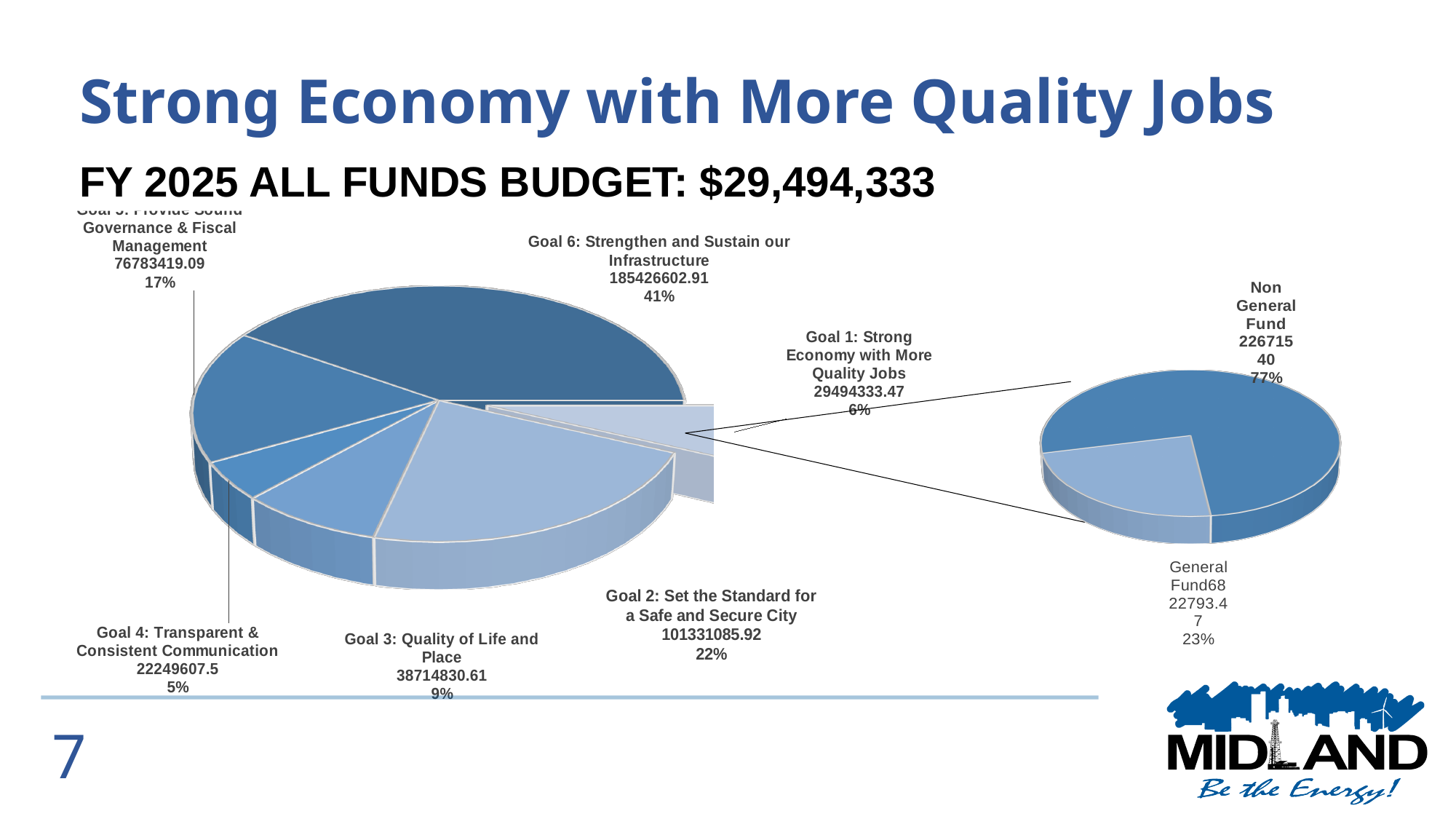
In the main pie chart, what share of the total does Goal 1: Strong Economy with More Quality Jobs represent? 6% In the main pie chart, what percentage is shown for Goal 2: Set the Standard for a Safe and Secure City? 22% In the smaller pie chart on the right, what percentage is shown for Non General Fund? 77% In the main pie chart, what is the value shown for Goal 6: Strengthen and Sustain our Infrastructure? 185426602.91 In the main pie chart, what is the value shown for Goal 3: Quality of Life and Place? 38714830.61 In the main pie chart, which goal has the largest slice? Goal 6: Strengthen and Sustain our Infrastructure How many goal slices are in the main pie chart? 6 In the main pie chart, which is larger: Goal 2: Set the Standard for a Safe and Secure City or Goal 3: Quality of Life and Place? Goal 2: Set the Standard for a Safe and Secure City In the main pie chart, what is the value shown for Goal 4: Transparent & Consistent Communication? 22249607.5 In the main pie chart, what is the difference between the value for Goal 2: Set the Standard for a Safe and Secure City and the value for Goal 3: Quality of Life and Place? 62616255.31 In the main pie chart, which goal has the smallest slice? Goal 4: Transparent & Consistent Communication What kind of chart is shown on the slide? Pie chart